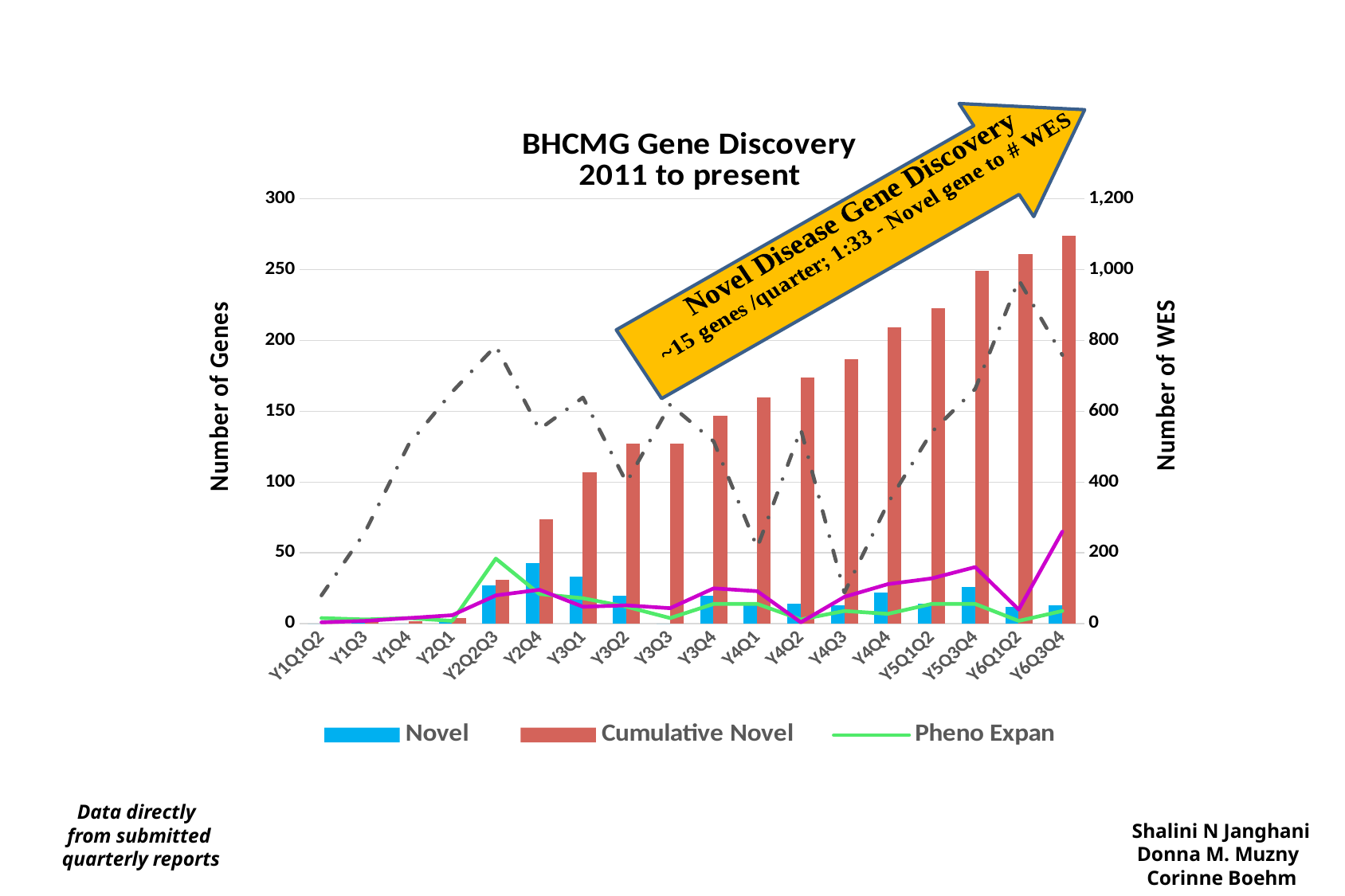
Which category has the tallest Novel bar? Y2Q4 What kind of chart is shown on the slide? A combined bar and line chart How many series does the legend of the BHCMG Gene Discovery chart list? 3 How many categories are shown along the x axis of the BHCMG Gene Discovery chart? 18 What is the title of the left vertical axis? Number of Genes Which has the larger Cumulative Novel value, Y4Q1 or Y3Q2? Y4Q1 What is the title of the right vertical axis? Number of WES Which category has the highest Cumulative Novel bar? Y6Q3Q4 Is the Cumulative Novel value for Y3Q1 greater or less than 100? greater Is the Cumulative Novel value for Y6Q3Q4 greater or less than 250? greater Is the Cumulative Novel value for Y2Q4 greater or less than 100? less Do the Cumulative Novel bars rise or fall from left to right along the x axis? Rise